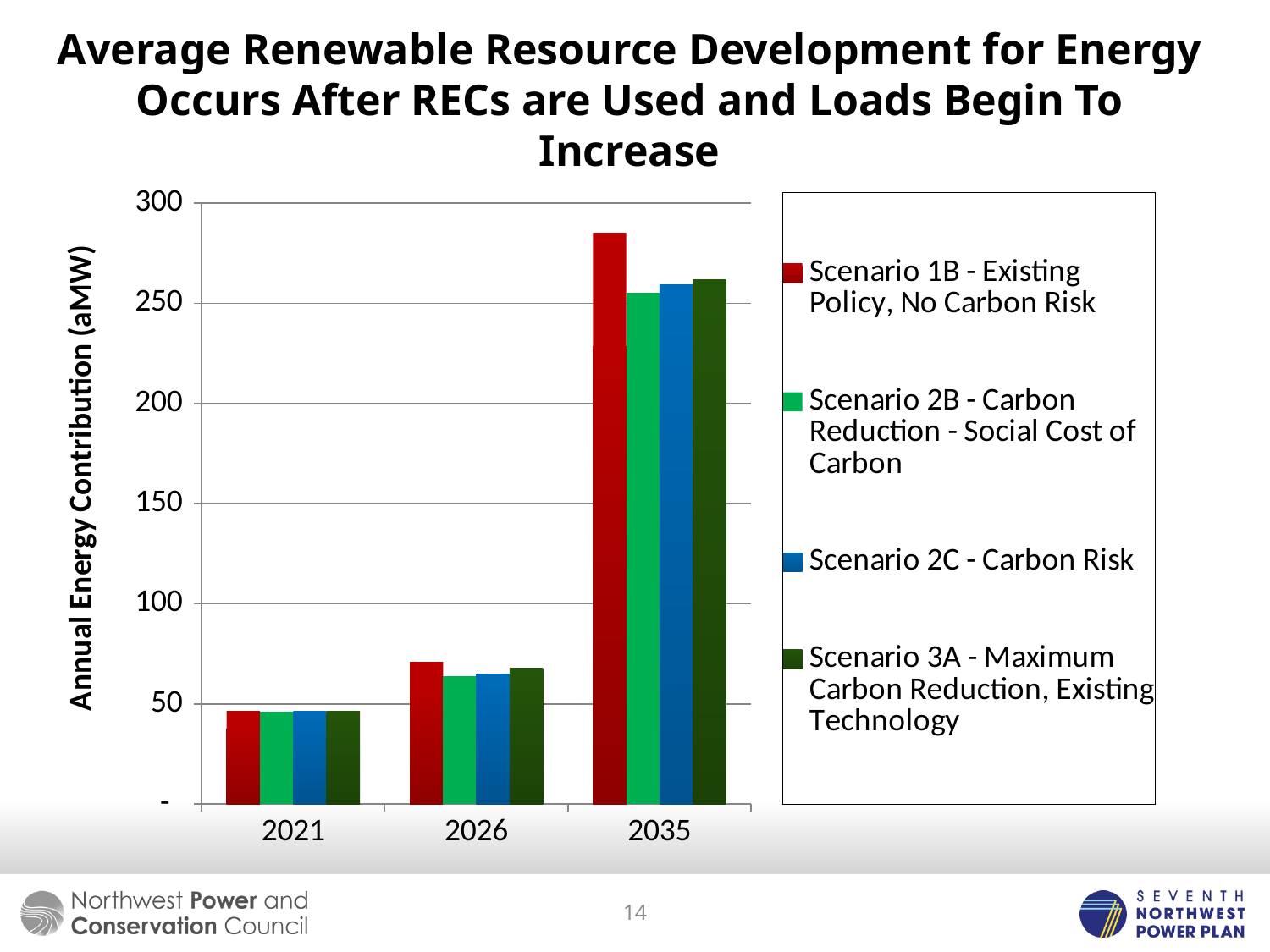
Do the values for Scenario 2C - Carbon Risk rise or fall from 2021 to 2035? rise Is the value for Scenario 3A - Maximum Carbon Reduction, Existing Technology in 2035 greater or less than 200? greater Is the value for Scenario 1B - Existing Policy, No Carbon Risk in 2026 greater or less than 50? greater Is the value for Scenario 2B - Carbon Reduction - Social Cost of Carbon in 2021 greater or less than 50? less What kind of chart is shown on the slide? bar chart How many series does the legend list? 4 In 2035, which is larger: Scenario 1B - Existing Policy, No Carbon Risk or Scenario 2B - Carbon Reduction - Social Cost of Carbon? Scenario 1B - Existing Policy, No Carbon Risk Which colour represents Scenario 2C - Carbon Risk in the legend? blue What is the title of the y axis? Annual Energy Contribution (aMW) Which scenario has the highest value in 2035? Scenario 1B - Existing Policy, No Carbon Risk How many year categories are shown on the x axis? 3